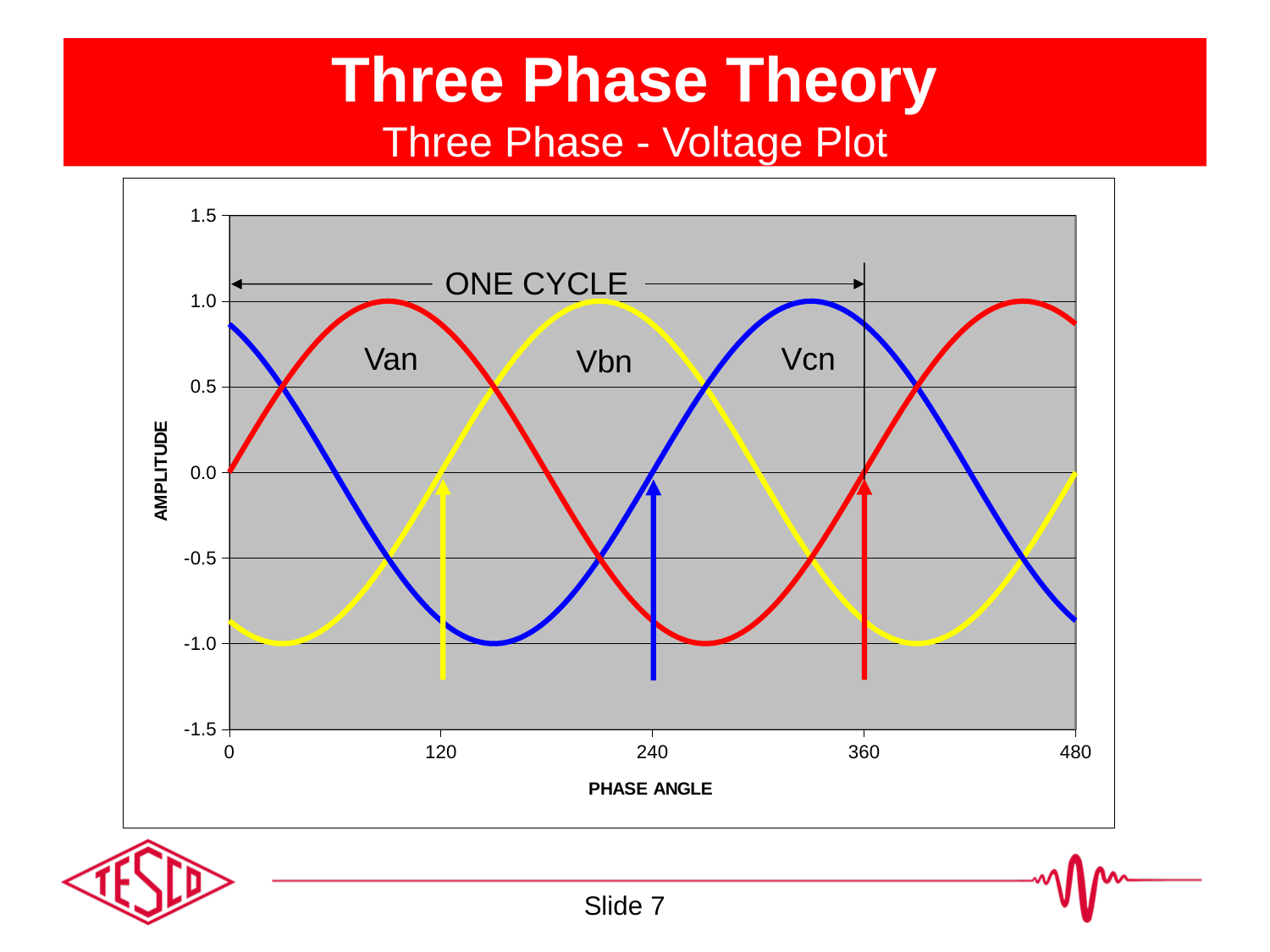
What is the amplitude of Vbn at a phase angle of 120? 0.0 What kind of chart is shown on the slide? line chart What is the title of the horizontal axis of the chart? PHASE ANGLE What is the maximum amplitude reached by the Van waveform? 1.0 What is the minimum amplitude reached by the Vcn waveform? -1.0 What is the amplitude of Vcn at a phase angle of 240? 0.0 Is the amplitude of Vcn at a phase angle of 0 greater or less than 0.5? greater At a phase angle of 0, which waveform has the larger amplitude, Vcn or Vbn? Vcn What is the amplitude of Van at a phase angle of 360? 0.0 Between phase angles 120 and 240, does the Van waveform rise or fall? fall How many voltage waveforms (series) are plotted on the chart? 3 What is the amplitude of Van at a phase angle of 0? 0.0